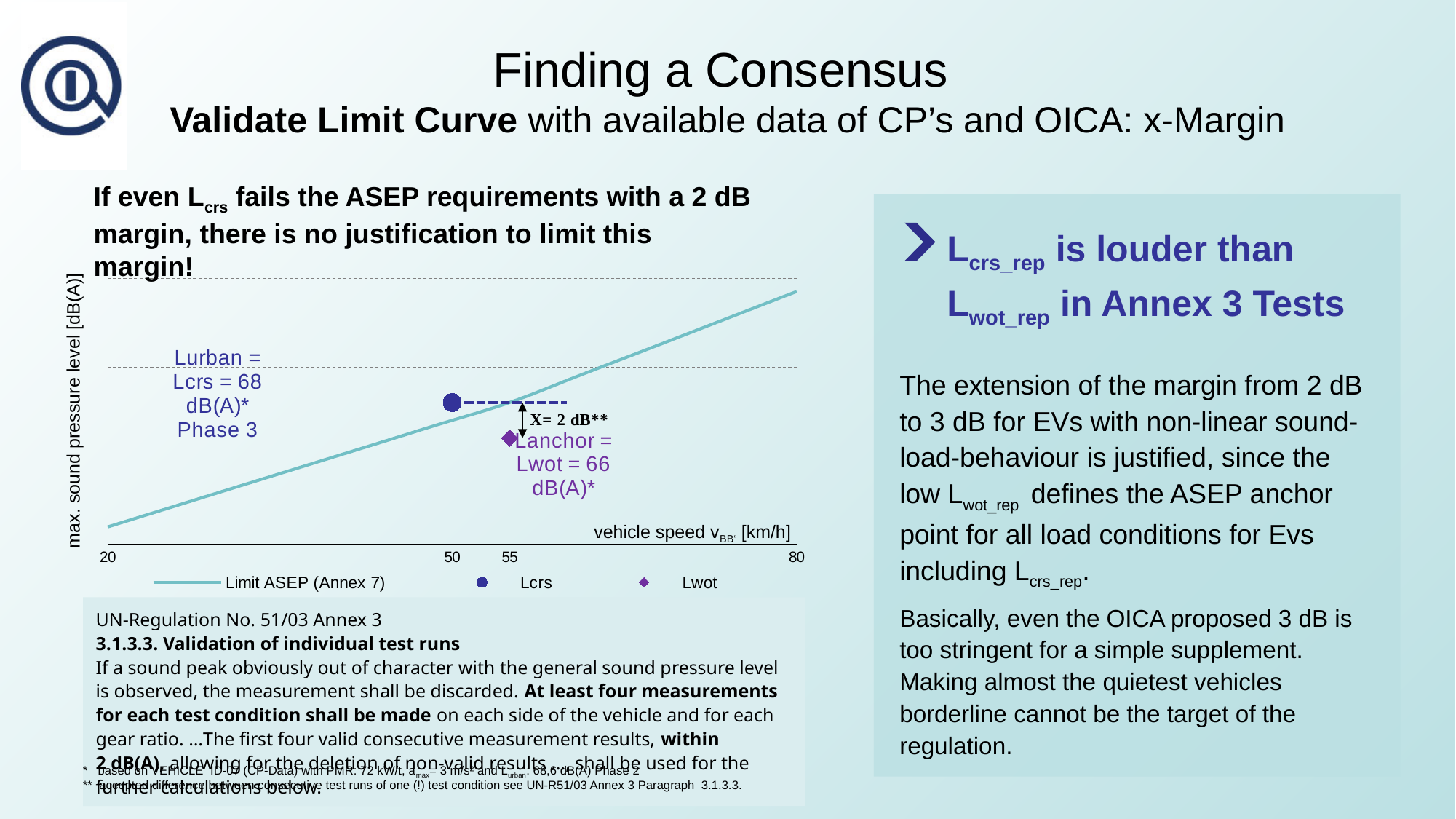
Does the Limit ASEP (Annex 7) line rise or fall as vehicle speed increases? Rises How many tick labels are shown on the x axis of the chart? 4 What kind of chart is shown on the slide? Line chart What is the label of the y axis of the chart? max. sound pressure level [dB(A)] What is the difference between the Lcrs value and the Lwot value shown on the chart? 2 dB(A) How many series does the chart legend list? 3 What value is given for Lcrs on the chart? 68 dB(A) At which vehicle speed on the x axis is the Lcrs point plotted? 50 At which vehicle speed on the x axis is the Lwot point plotted? 55 What is the legend entry for the line series in the chart? Limit ASEP (Annex 7) Which is larger on the chart, Lcrs or Lwot? Lcrs What value is given for Lwot on the chart? 66 dB(A)